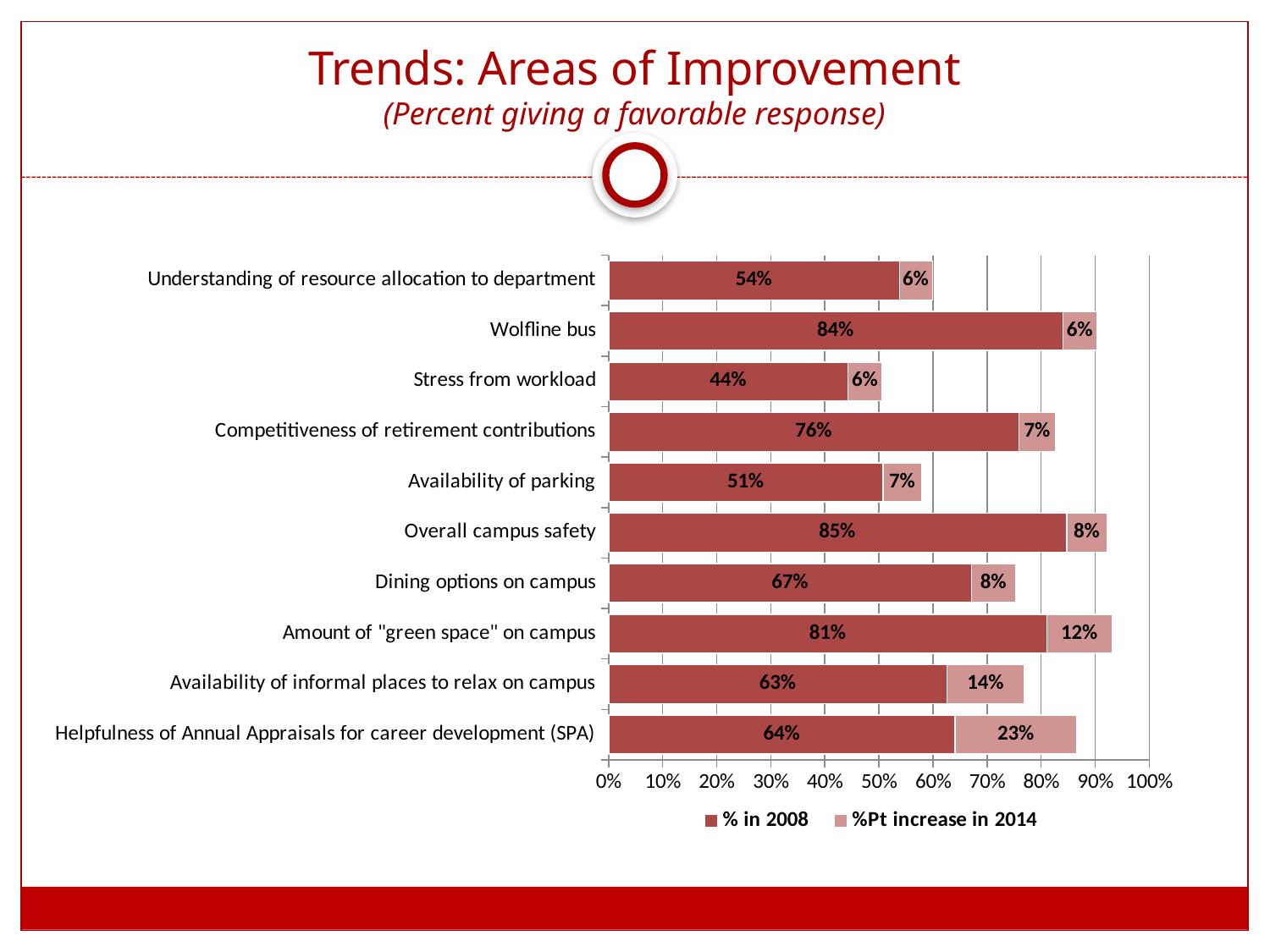
How many series does the legend list? 2 Which has a higher "% in 2008" value, Dining options on campus or Availability of informal places to relax on campus? Dining options on campus What is the difference between the "% in 2008" values for Overall campus safety and Availability of parking? 34% What kind of chart is shown on the slide? Stacked bar chart Which category has the lowest "% in 2008" value? Stress from workload Which category has the highest "% in 2008" value? Overall campus safety What is the "% in 2008" value for Stress from workload? 44% What is the "% in 2008" value for Wolfline bus? 84% How many categories are shown on the chart? 10 Which category has the largest "%Pt increase in 2014"? Helpfulness of Annual Appraisals for career development (SPA) What is the total of the stacked bar for Amount of "green space" on campus? 93% What is the "%Pt increase in 2014" value for Helpfulness of Annual Appraisals for career development (SPA)? 23%